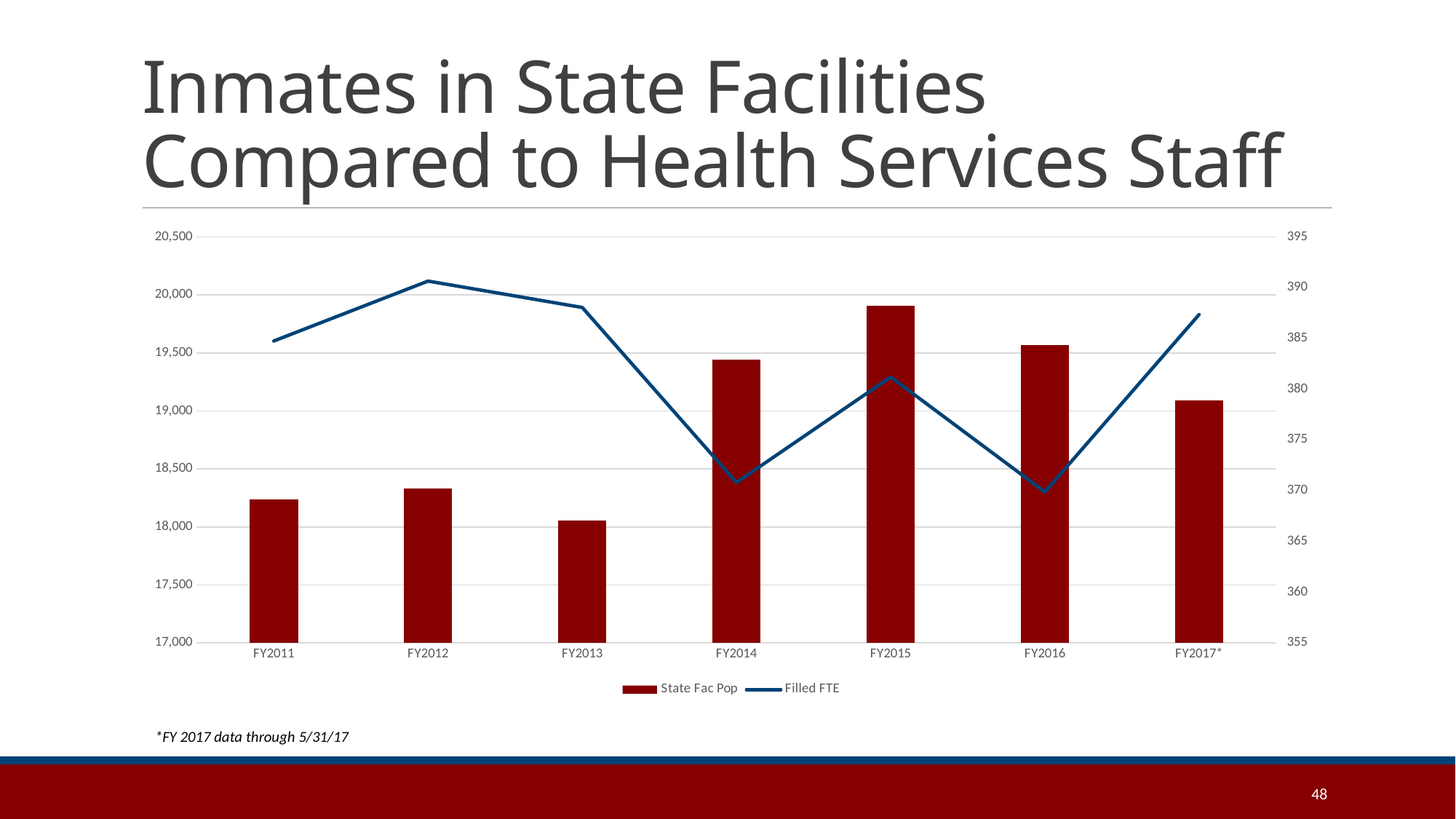
Does the State Fac Pop rise or fall from FY2015 to FY2017*? fall Which is larger, the State Fac Pop for FY2011 or for FY2014? FY2014 Is the State Fac Pop value for FY2015 greater or less than 19,500? greater Which is larger, the Filled FTE for FY2013 or for FY2014? FY2013 Which fiscal year has the lowest State Fac Pop bar? FY2013 Is the Filled FTE value for FY2012 greater or less than 385? greater How many series does the legend list? 2 Is the State Fac Pop value for FY2013 greater or less than 18,500? less How many fiscal years are shown on the x axis? 7 Which fiscal year has the highest State Fac Pop bar? FY2015 In which fiscal year does the Filled FTE line reach its highest point? FY2012